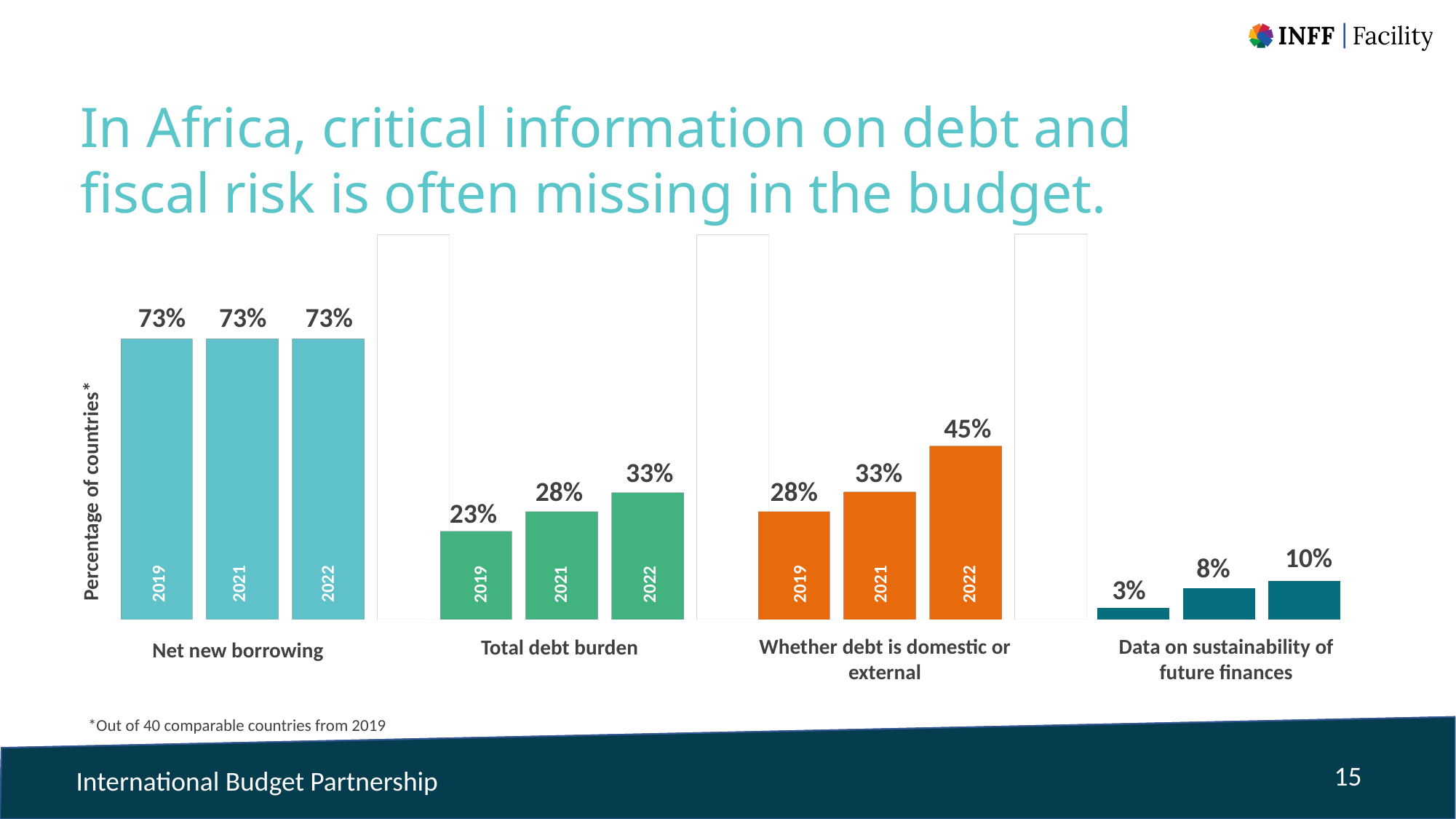
What is the value for Total debt burden in 2021? 28% What is the difference between the 2022 and 2019 values for Whether debt is domestic or external? 17 percentage points Which is larger: Total debt burden in 2022 or Whether debt is domestic or external in 2021? They are equal (33%) What is the value for Whether debt is domestic or external in 2022? 45% Which category has the lowest values across all years? Data on sustainability of future finances What percentage of countries is shown for Net new borrowing in 2022? 73% Which category has the highest values across all years? Net new borrowing Do the values for Total debt burden rise or fall from 2019 to 2022? Rise What type of chart is shown on the slide? Bar chart What is the value for Total debt burden in 2019? 23% How many category groups are shown on the x axis? 4 How many years are plotted for each category? 3